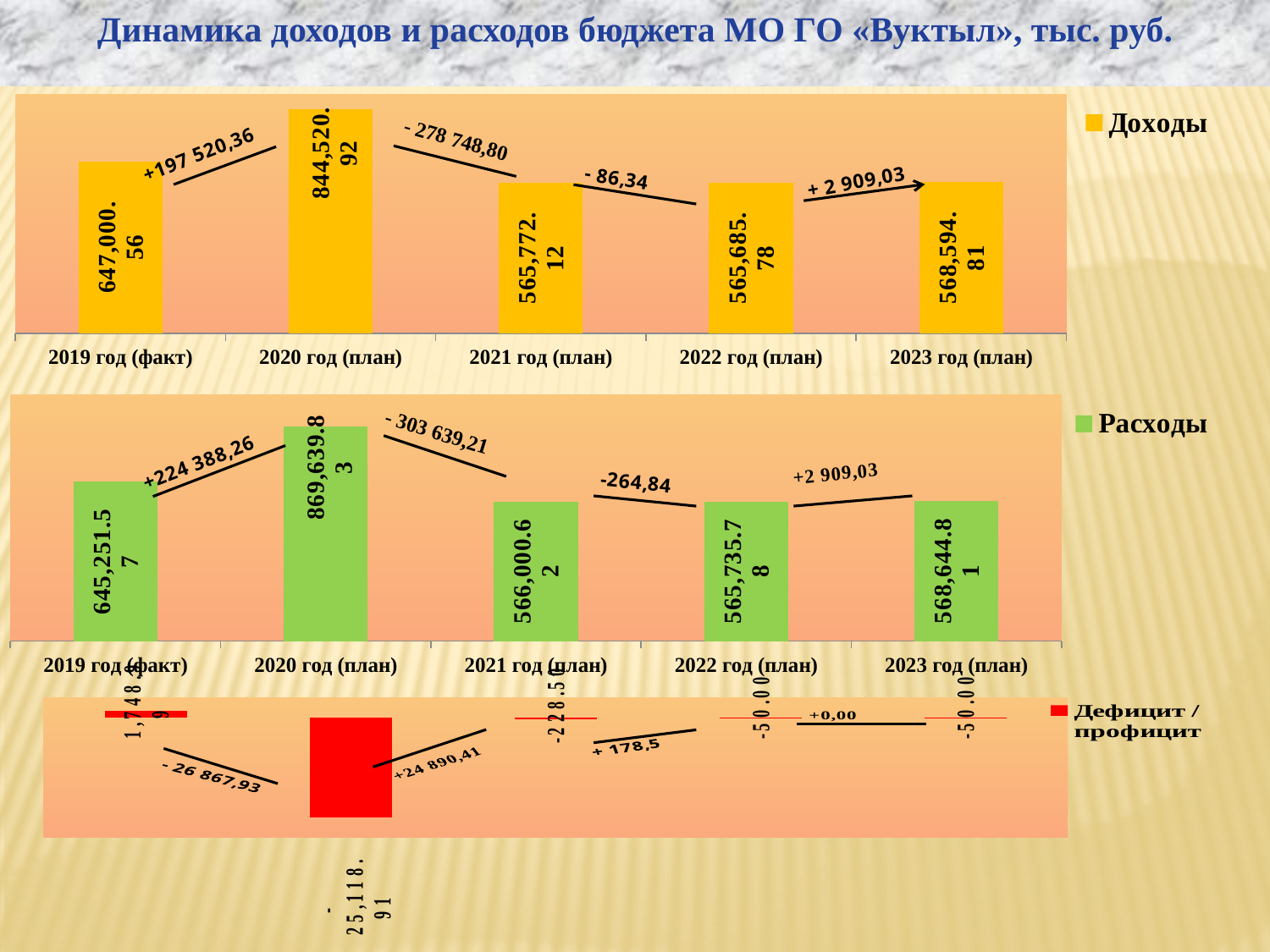
What is the legend label of the bottom chart on the slide? Дефицит / профицит How many years are shown in the Доходы chart? 5 In the Доходы chart, do the values rise or fall from 2020 год (план) to 2022 год (план)? fall What kind of chart is the Расходы chart? bar chart In the Расходы chart, what is the value for 2021 год (план)? 566,000.62 In the Доходы chart, which year has the highest value? 2020 год (план) In the Доходы chart, what is the value for 2020 год (план)? 844,520.92 In the Доходы chart, what is the difference between the values for 2023 год (план) and 2022 год (план)? 2,909.03 In the Расходы chart, which year has the lowest value? 2022 год (план) In the Расходы chart, which is larger: the value for 2019 год (факт) or 2020 год (план)? 2020 год (план) In the Дефицит / профицит chart, what is the value for 2020 год (план)? -25,118.91 In the Доходы chart, what change is annotated between 2019 год (факт) and 2020 год (план)? +197 520,36